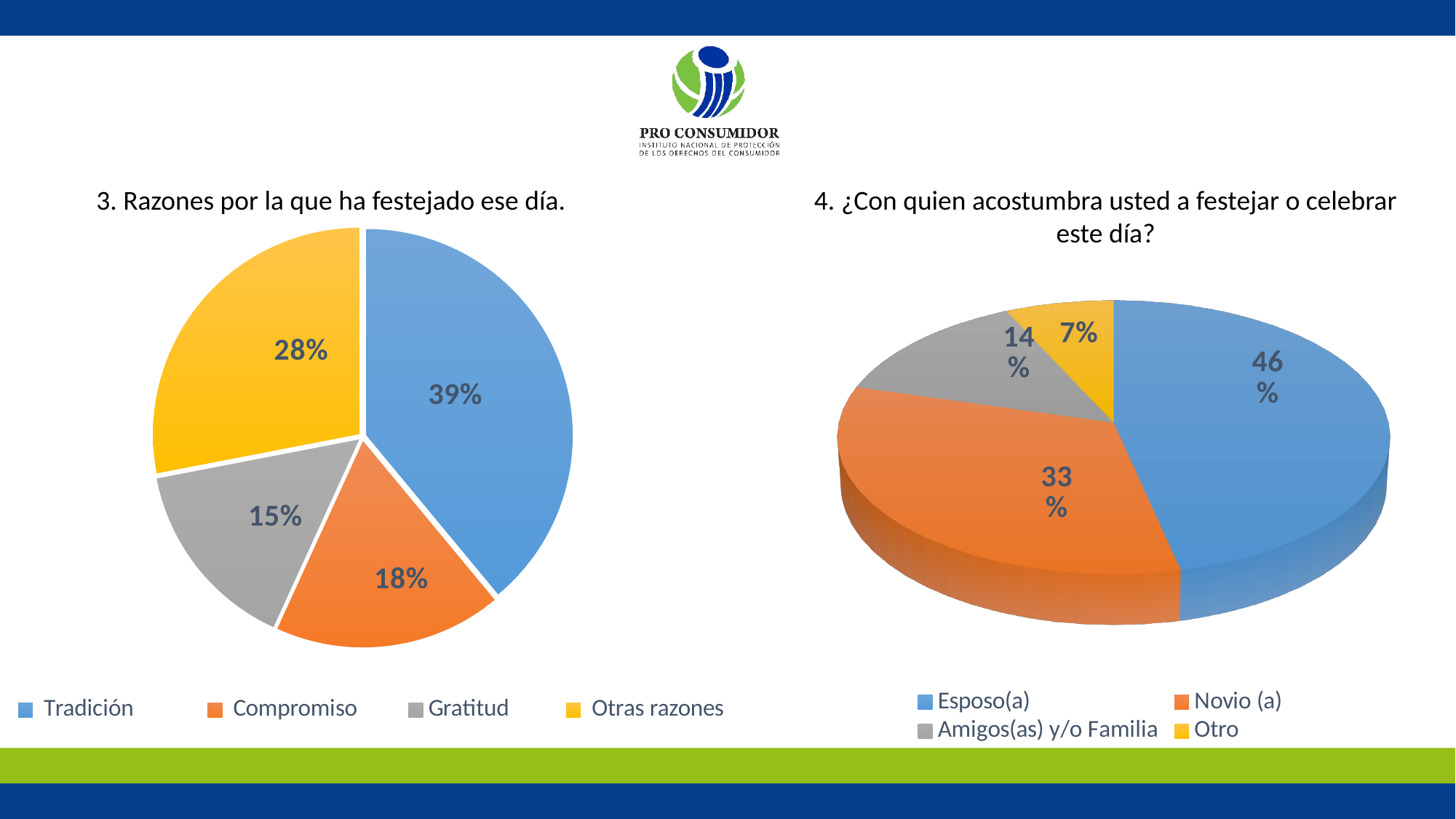
In the left chart '3. Razones por la que ha festejado ese día.', which category has the smallest slice? Gratitud In the right chart '4. ¿Con quien acostumbra usted a festejar o celebrar este día?', what is the difference in percentage points between Esposo(a) and Novio (a)? 13 In the right chart '4. ¿Con quien acostumbra usted a festejar o celebrar este día?', what percentage is shown for Esposo(a)? 46% In the left chart '3. Razones por la que ha festejado ese día.', what percentage is shown for Tradición? 39% In the left chart '3. Razones por la que ha festejado ese día.', what percentage is shown for Gratitud? 15% In the left chart '3. Razones por la que ha festejado ese día.', what is the difference in percentage points between Otras razones and Compromiso? 10 In the left chart '3. Razones por la que ha festejado ese día.', how many categories are shown? 4 In the right chart '4. ¿Con quien acostumbra usted a festejar o celebrar este día?', which is larger, Novio (a) or Amigos(as) y/o Familia? Novio (a) In the right chart '4. ¿Con quien acostumbra usted a festejar o celebrar este día?', which category has the smallest slice? Otro In the left chart '3. Razones por la que ha festejado ese día.', which category has the largest slice? Tradición In the right chart '4. ¿Con quien acostumbra usted a festejar o celebrar este día?', what percentage is shown for Otro? 7% What type of chart is the right chart '4. ¿Con quien acostumbra usted a festejar o celebrar este día?'? Pie chart